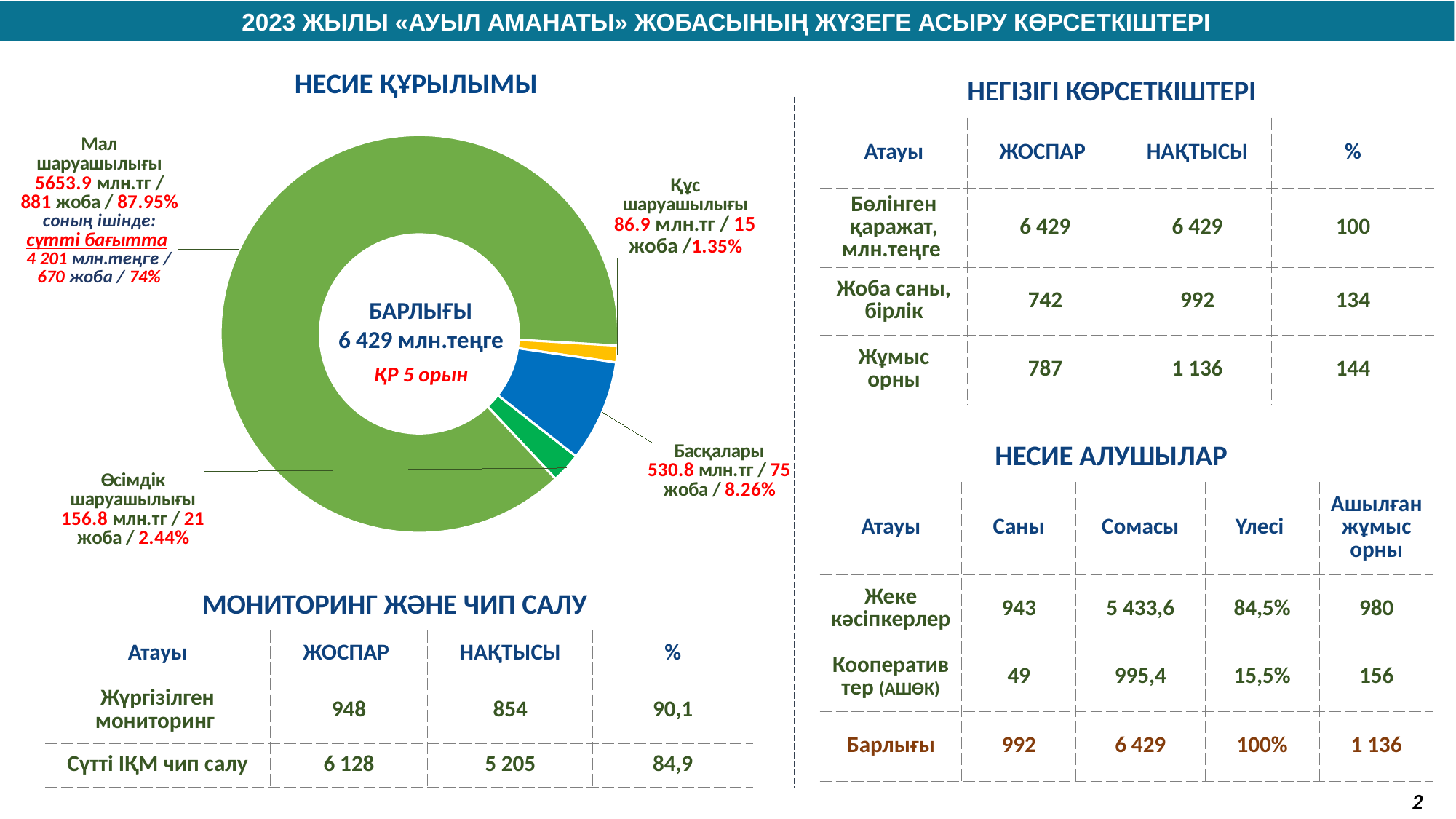
In the «НЕСИЕ ҚҰРЫЛЫМЫ» chart, what is the difference in млн.тг between «Өсімдік шаруашылығы» and «Құс шаруашылығы»? 69.9 млн.тг In the «НЕСИЕ ҚҰРЫЛЫМЫ» chart, what amount in млн.тг is shown for «Мал шаруашылығы»? 5653.9 млн.тг In the «НЕСИЕ ҚҰРЫЛЫМЫ» chart, how many segments does the donut have? 4 What kind of chart is shown under the title «НЕСИЕ ҚҰРЫЛЫМЫ»? Pie (donut) chart In the «НЕСИЕ ҚҰРЫЛЫМЫ» chart, what share does «Құс шаруашылығы» have? 1.35% In the «НЕСИЕ ҚҰРЫЛЫМЫ» chart, what share of the total does «Мал шаруашылығы» account for? 87.95% In the «НЕСИЕ ҚҰРЫЛЫМЫ» chart, which segment is the smallest? Құс шаруашылығы What total value (БАРЛЫҒЫ) is shown in the centre of the «НЕСИЕ ҚҰРЫЛЫМЫ» donut chart? 6 429 млн.теңге In the «НЕСИЕ ҚҰРЫЛЫМЫ» chart, which is larger: «Басқалары» or «Өсімдік шаруашылығы»? Басқалары In the «НЕСИЕ ҚҰРЫЛЫМЫ» chart, which segment is the largest? Мал шаруашылығы In the «НЕСИЕ ҚҰРЫЛЫМЫ» chart, what amount in млн.тг is shown for «Басқалары»? 530.8 млн.тг In the «НЕСИЕ ҚҰРЫЛЫМЫ» chart, how many projects (жоба) are shown for «Өсімдік шаруашылығы»? 21